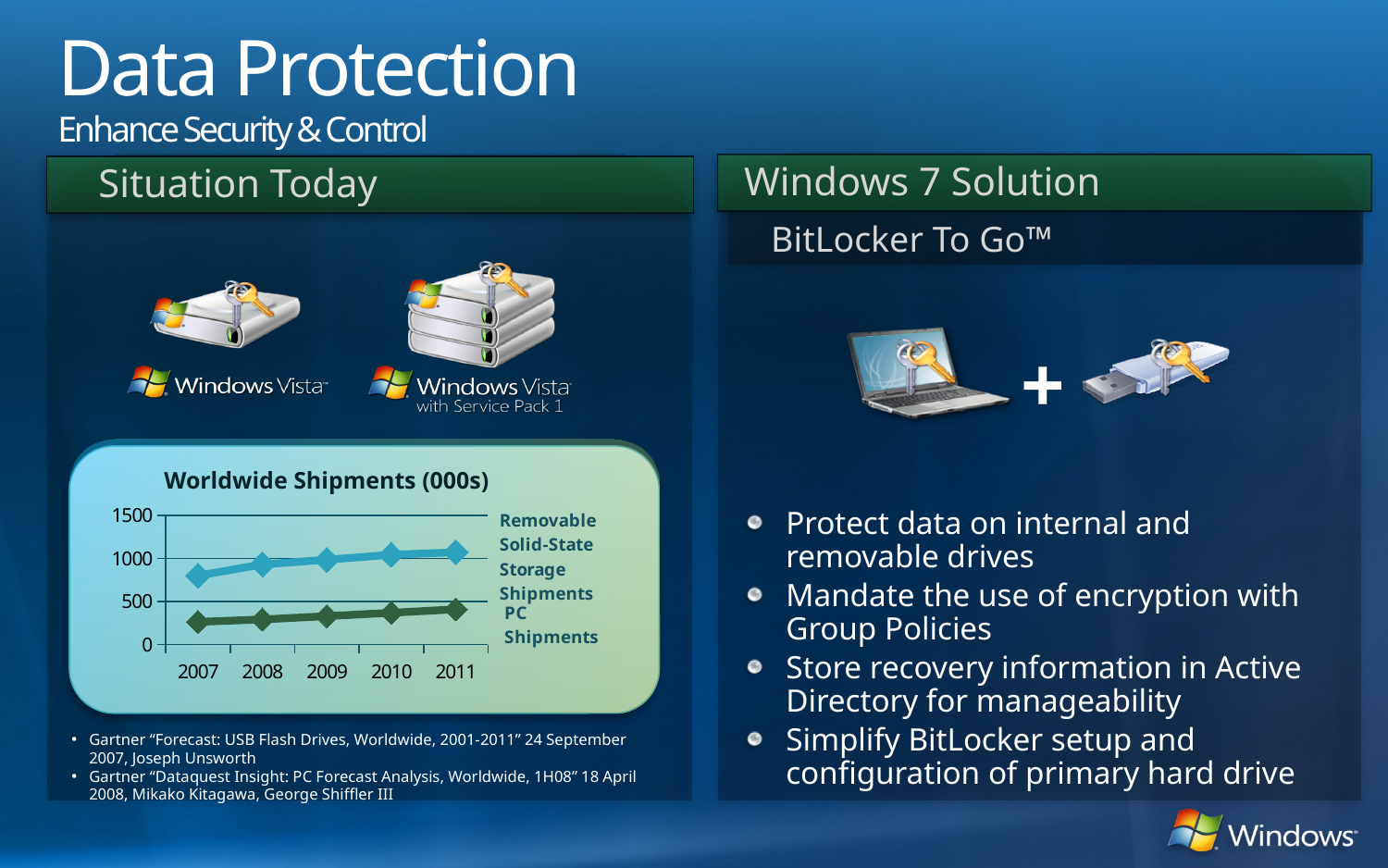
In the Worldwide Shipments chart, which year has the highest value for Removable Solid-State Storage Shipments? 2011 In the Worldwide Shipments chart, do PC Shipments rise or fall from 2007 to 2011? rise In the Worldwide Shipments chart, is the value for PC Shipments in 2011 greater or less than 500? less How many series does the legend of the Worldwide Shipments chart list? 2 In the Worldwide Shipments chart, is the value for Removable Solid-State Storage Shipments in 2007 greater or less than 1000? less In the Worldwide Shipments chart, which series has the larger value in 2009, Removable Solid-State Storage Shipments or PC Shipments? Removable Solid-State Storage Shipments In the Worldwide Shipments chart, do Removable Solid-State Storage Shipments rise or fall from 2007 to 2011? rise In the Worldwide Shipments chart, which year has the lowest value for PC Shipments? 2007 How many years are shown on the x axis of the Worldwide Shipments chart? 5 What is the title of the chart on the slide? Worldwide Shipments (000s) What type of chart is shown under the title "Worldwide Shipments (000s)"? line chart In the Worldwide Shipments chart, is the value for Removable Solid-State Storage Shipments in 2011 greater or less than 1000? greater